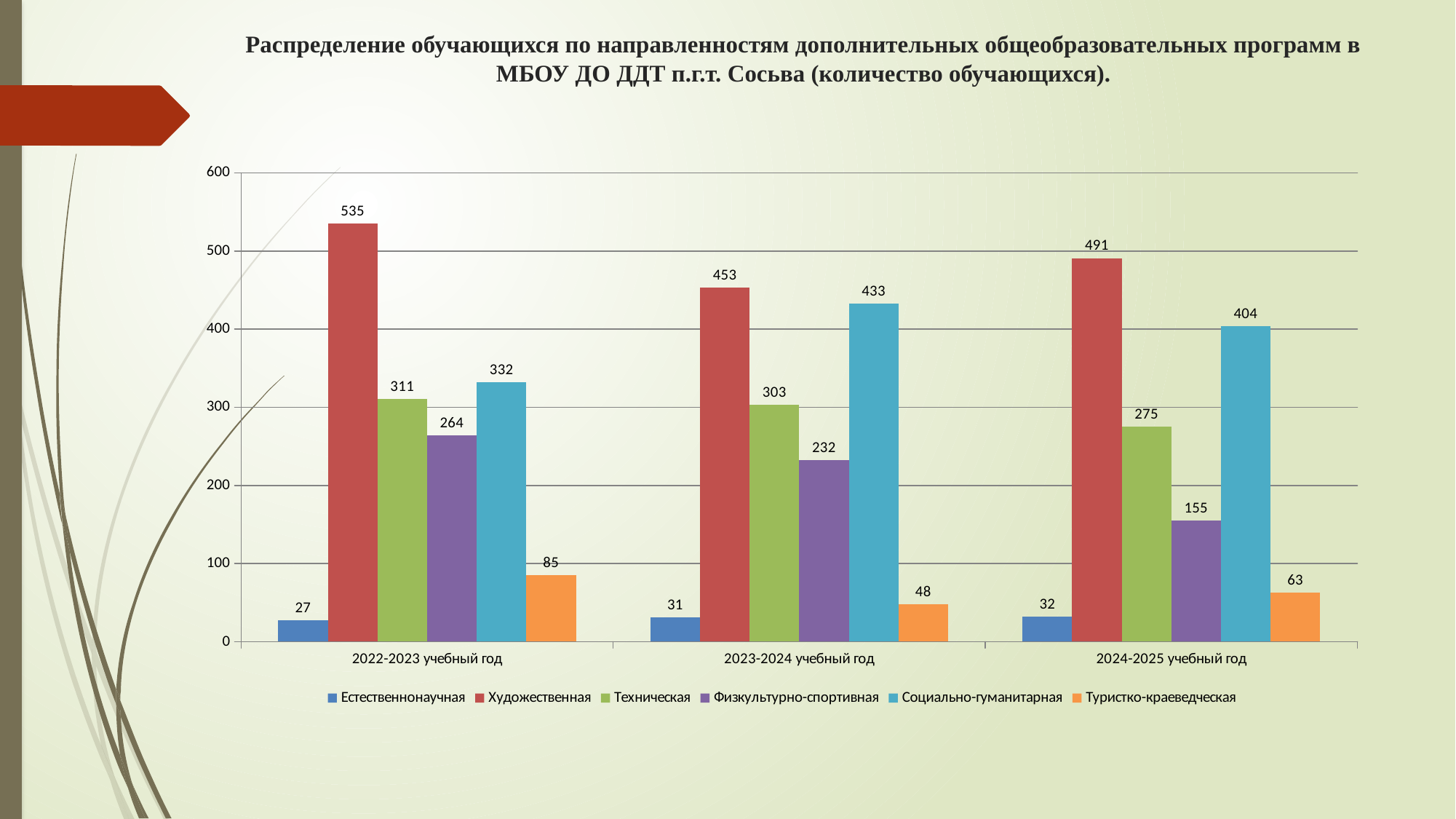
What kind of chart is shown on the slide? Bar chart What is the value for Физкультурно-спортивная in 2023-2024 учебный год? 232 How many academic year categories are shown on the x axis? 3 What is the value for Социально-гуманитарная in 2024-2025 учебный год? 404 What is the value for Художественная in 2022-2023 учебный год? 535 What colour are the bars for Туристко-краеведческая? Orange Which series has the lowest value in 2024-2025 учебный год? Естественнонаучная What is the difference between Художественная and Социально-гуманитарная in 2024-2025 учебный год? 87 Which series has the highest value in 2023-2024 учебный год? Художественная Does the value for Физкультурно-спортивная rise or fall from 2022-2023 to 2024-2025? Fall How many series does the legend list? 6 Which is larger in 2022-2023 учебный год: Техническая or Социально-гуманитарная? Социально-гуманитарная